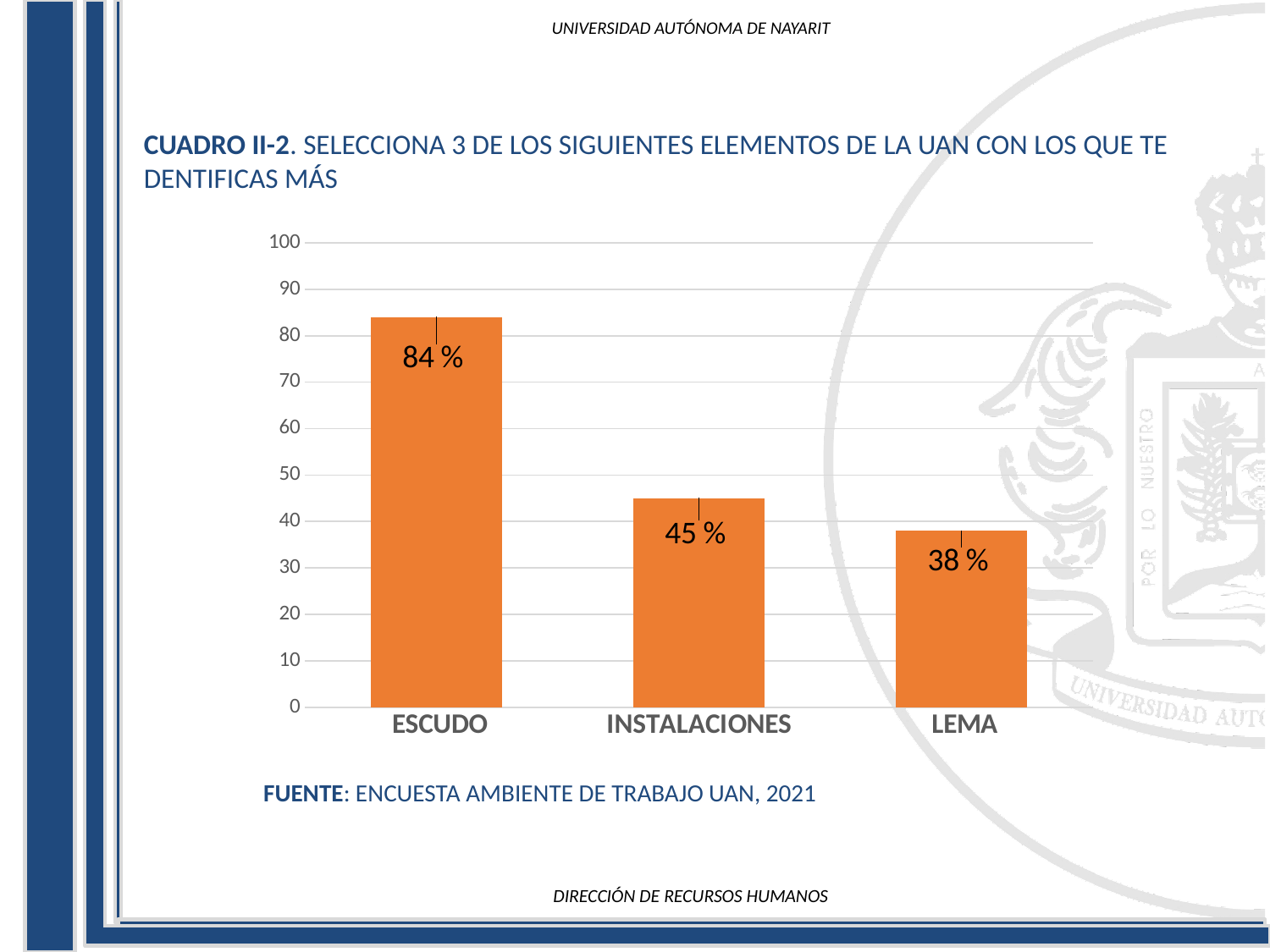
What is the value for ESCUDO? 84 % Which is larger, the value for INSTALACIONES or the value for LEMA? INSTALACIONES How many categories are shown in the chart? 3 Do the values rise or fall from left to right across the categories? fall What is the difference between the values for INSTALACIONES and LEMA? 7 % Which category has the lowest value? LEMA What is the difference between the values for ESCUDO and INSTALACIONES? 39 % What is the value for INSTALACIONES? 45 % Which category has the highest value? ESCUDO What kind of chart is shown on the slide? bar chart What is the value for LEMA? 38 % Is the value for ESCUDO greater or less than 80? greater